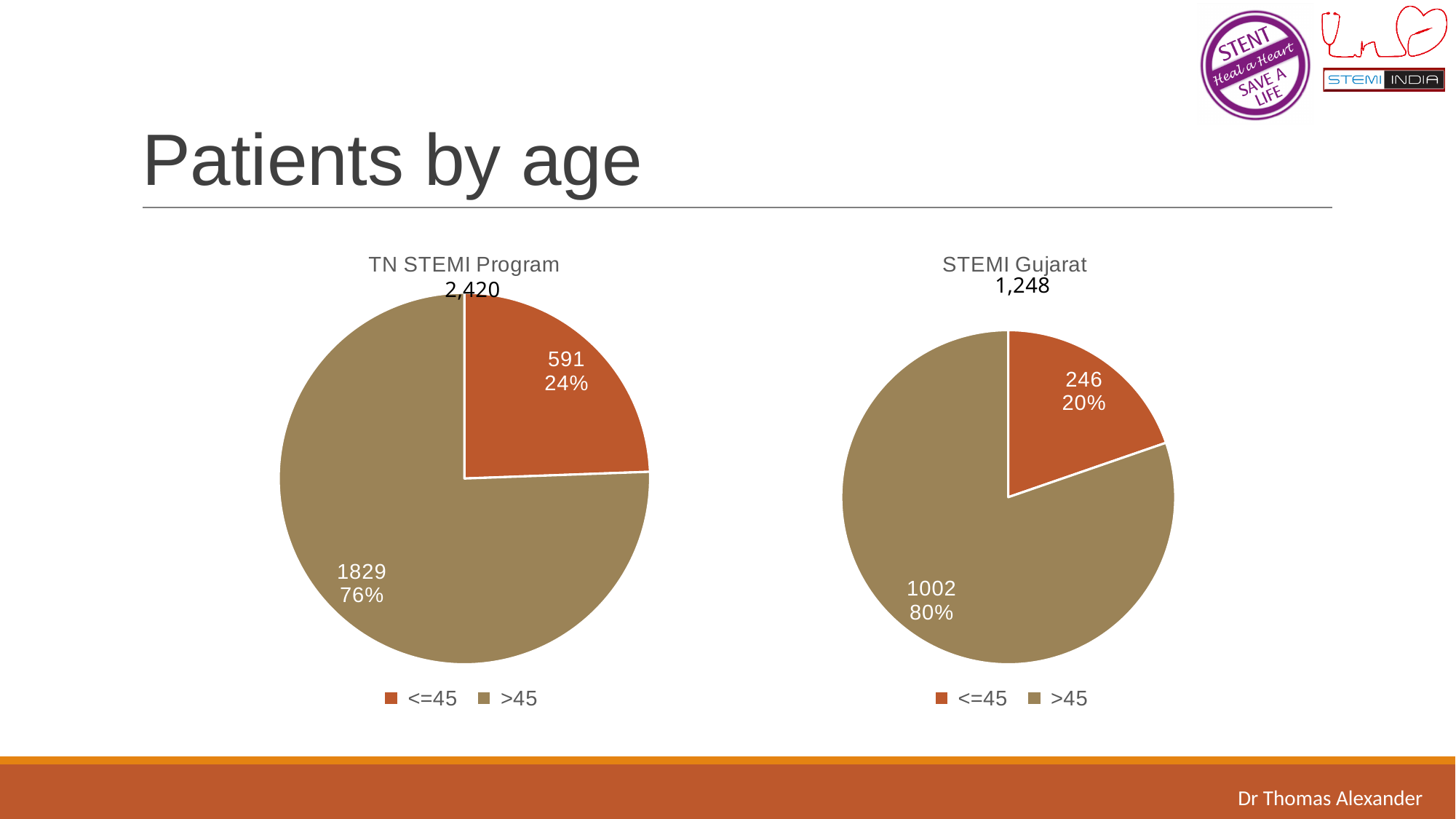
What type of chart is used for the TN STEMI Program data? Pie chart In the STEMI Gujarat chart, which age group has the smallest slice? <=45 How many categories does the STEMI Gujarat chart show? 2 Is the <=45 count larger in the TN STEMI Program chart or the STEMI Gujarat chart? TN STEMI Program In the TN STEMI Program chart, how many patients are in the <=45 group? 591 In the TN STEMI Program chart, what is the difference between the >45 and <=45 patient counts? 1238 What total is printed above the TN STEMI Program chart? 2,420 In the STEMI Gujarat chart, what share of patients are <=45? 20% In the TN STEMI Program chart, which age group has the largest slice? >45 In the TN STEMI Program chart, what percentage of patients are >45? 76% In the STEMI Gujarat chart, how many patients are in the >45 group? 1002 In the STEMI Gujarat chart, what is the difference between the >45 and <=45 patient counts? 756